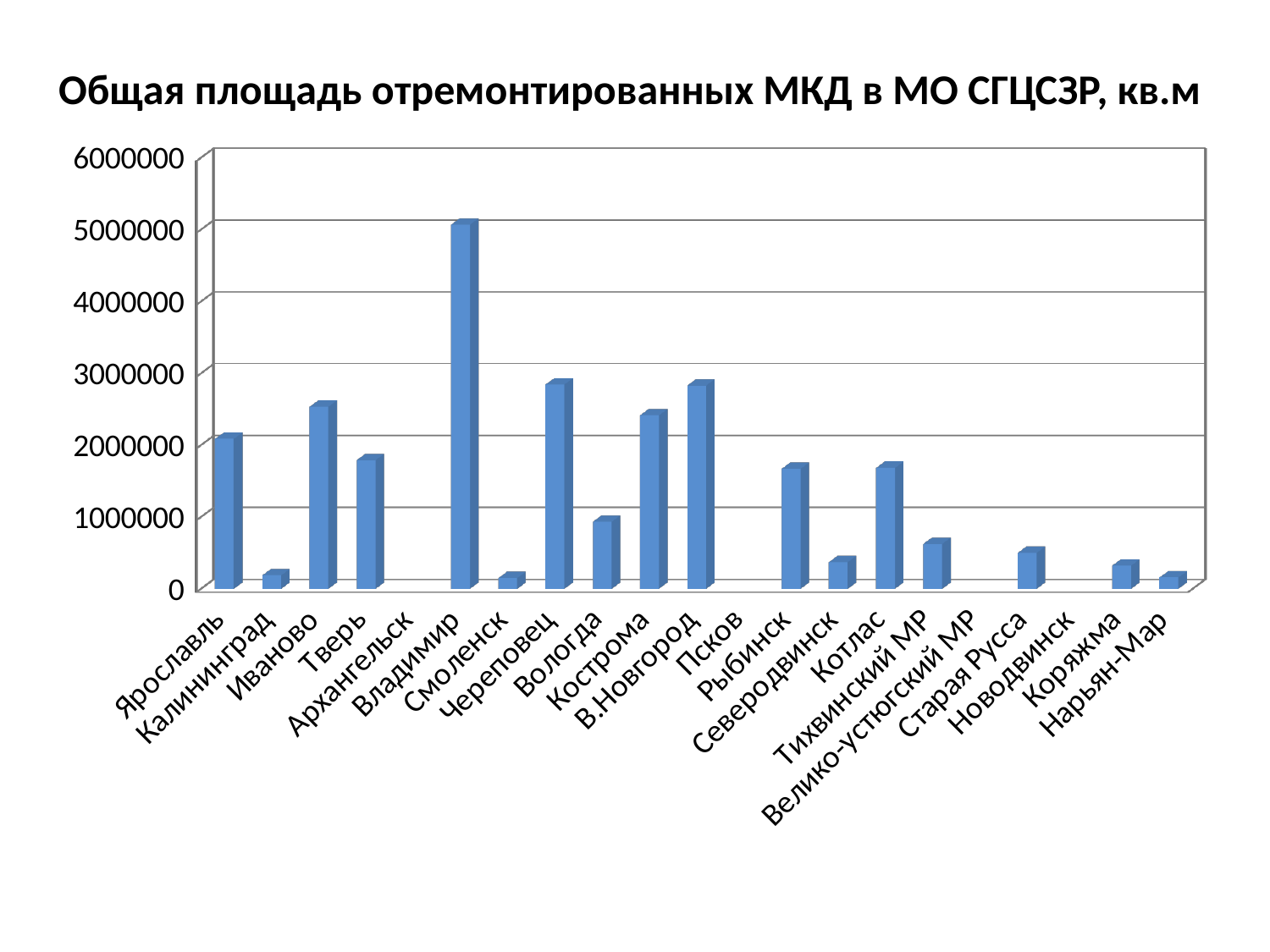
Which is larger, the value for Кострома or the value for Вологда? Кострома Which is larger, the value for Владимир or the value for Череповец? Владимир Which category has the highest value in the chart? Владимир Is the value for Владимир greater or less than 4000000? greater Which is larger, the value for Иваново or the value for Тверь? Иваново What is the title of the chart? Общая площадь отремонтированных МКД в МО СГЦСЗР, кв.м Is the value for Тверь greater or less than 2000000? less Is the value for Калининград greater or less than 1000000? less What kind of chart is shown on the slide? bar chart How many categories are shown on the x axis of the chart? 21